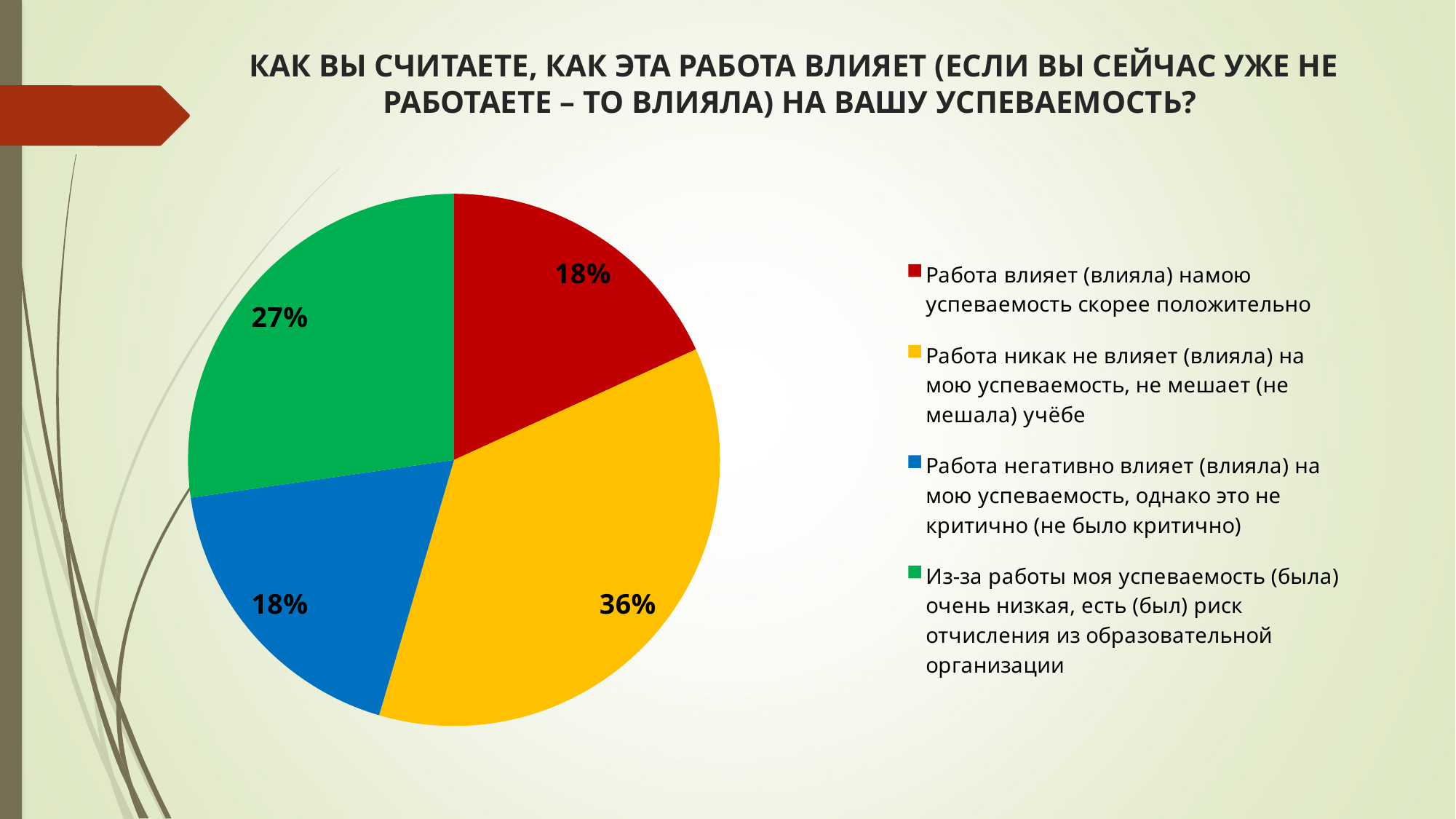
How many slices does the pie chart have? 4 What is the difference between the yellow slice and the blue slice? 18% What kind of chart is shown on the slide? pie chart What value is shown for "Работа влияет (влияла) намою успеваемость скорее положительно"? 18% Which is larger: the green slice or the red slice? the green slice What value is shown for "Работа негативно влияет (влияла) на мою успеваемость, однако это не критично (не было критично)"? 18% What share of the pie is the slice "Из-за работы моя успеваемость (была) очень низкая, есть (был) риск отчисления из образовательной организации"? 27% Which category has the largest slice of the pie? Работа никак не влияет (влияла) на мою успеваемость, не мешает (не мешала) учёбе What colour is the slice for "Работа никак не влияет (влияла) на мою успеваемость, не мешает (не мешала) учёбе"? yellow What is the difference between the largest slice (36%) and the green slice (27%)? 9% How many entries does the legend list? 4 What share of the pie is the slice "Работа никак не влияет (влияла) на мою успеваемость, не мешает (не мешала) учёбе"? 36%